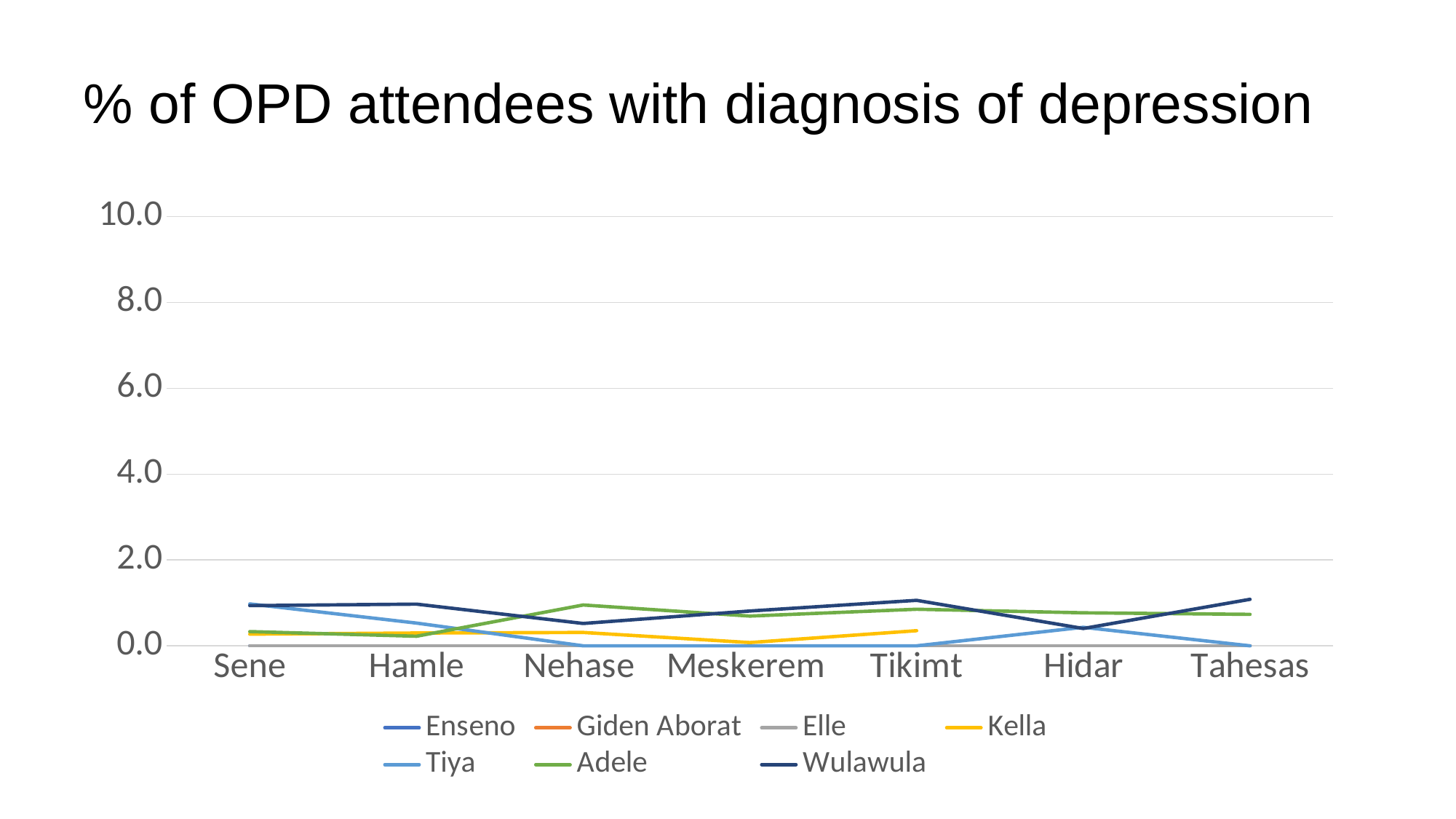
Is the value for Adele at Nehase greater or less than 2.0? less What is the title of the chart? % of OPD attendees with diagnosis of depression What is the first category on the x axis? Sene Is the value for Kella at Tikimt greater or less than 2.0? less Does the Wulawula line rise or fall from Hidar to Tahesas? rise How many categories are shown on the x axis? 7 Does the Tiya line rise or fall from Sene to Nehase? fall Is the value for Wulawula at Tahesas greater or less than 2.0? less How many series does the legend list? 7 What is the highest value shown on the y axis? 10.0 What kind of chart is shown on the slide? line chart